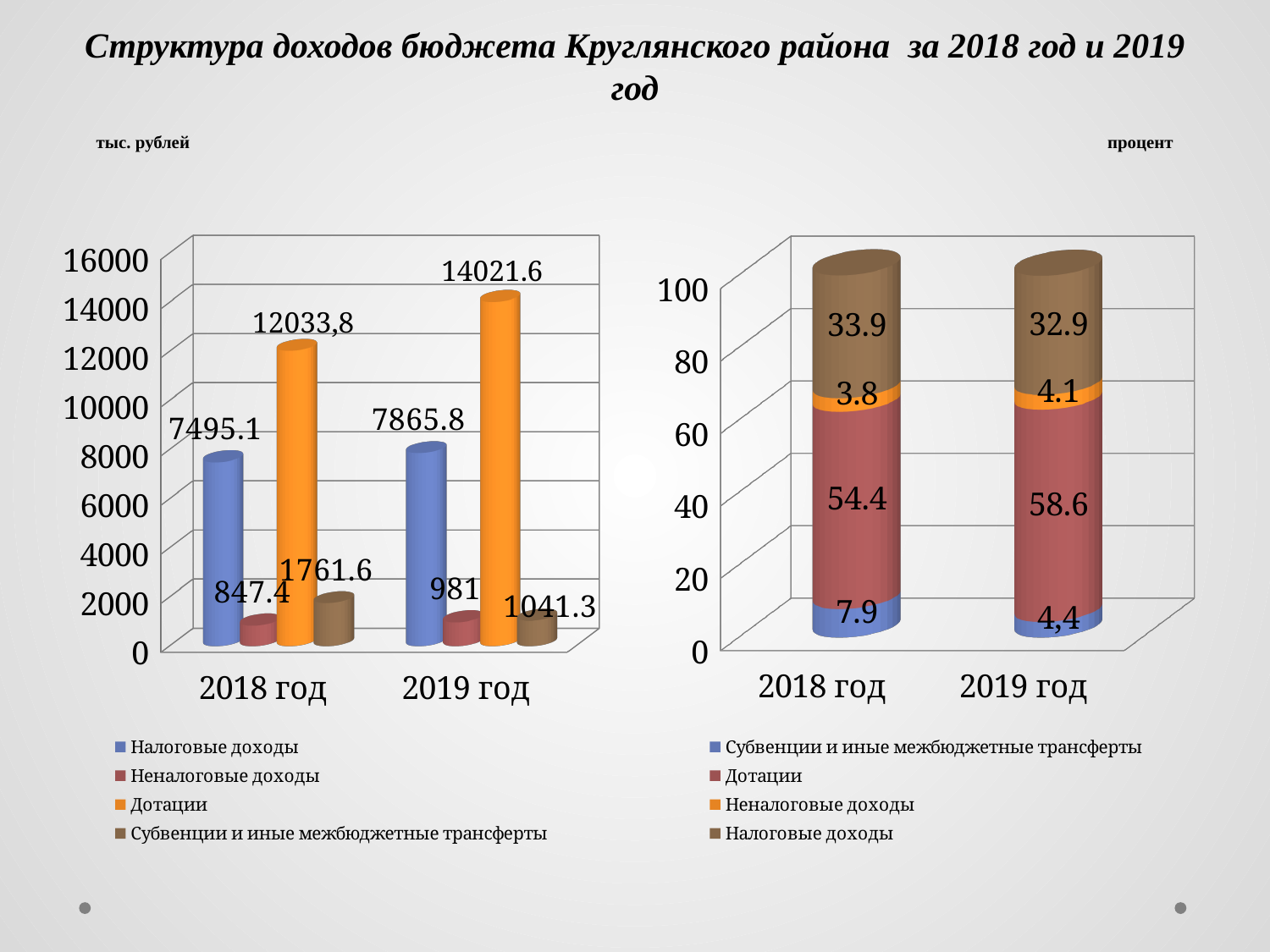
On the right chart (процент), which is larger: Налоговые доходы in 2018 год or in 2019 год? 2018 год On the left chart (тыс. рублей), how many series does the legend list? 4 On the left chart (тыс. рублей), is the value of Налоговые доходы for 2019 год greater or less than 8000? less On the left chart (тыс. рублей), what is the value of Налоговые доходы for 2018 год? 7495.1 On the left chart (тыс. рублей), which series has the lowest value for 2019 год? Неналоговые доходы On the left chart (тыс. рублей), which series has the highest value for 2018 год? Дотации On the left chart (тыс. рублей), what is the difference between Субвенции и иные межбюджетные трансферты in 2018 год and in 2019 год? 720.3 On the left chart (тыс. рублей), what is the value of Неналоговые доходы for 2019 год? 981 What type of chart is the right chart (процент)? stacked bar chart On the left chart (тыс. рублей), what is the value of Дотации for 2019 год? 14021.6 On the right chart (процент), what is the share of Дотации for 2019 год? 58.6 On the right chart (процент), what is the value of Субвенции и иные межбюджетные трансферты for 2018 год? 7.9